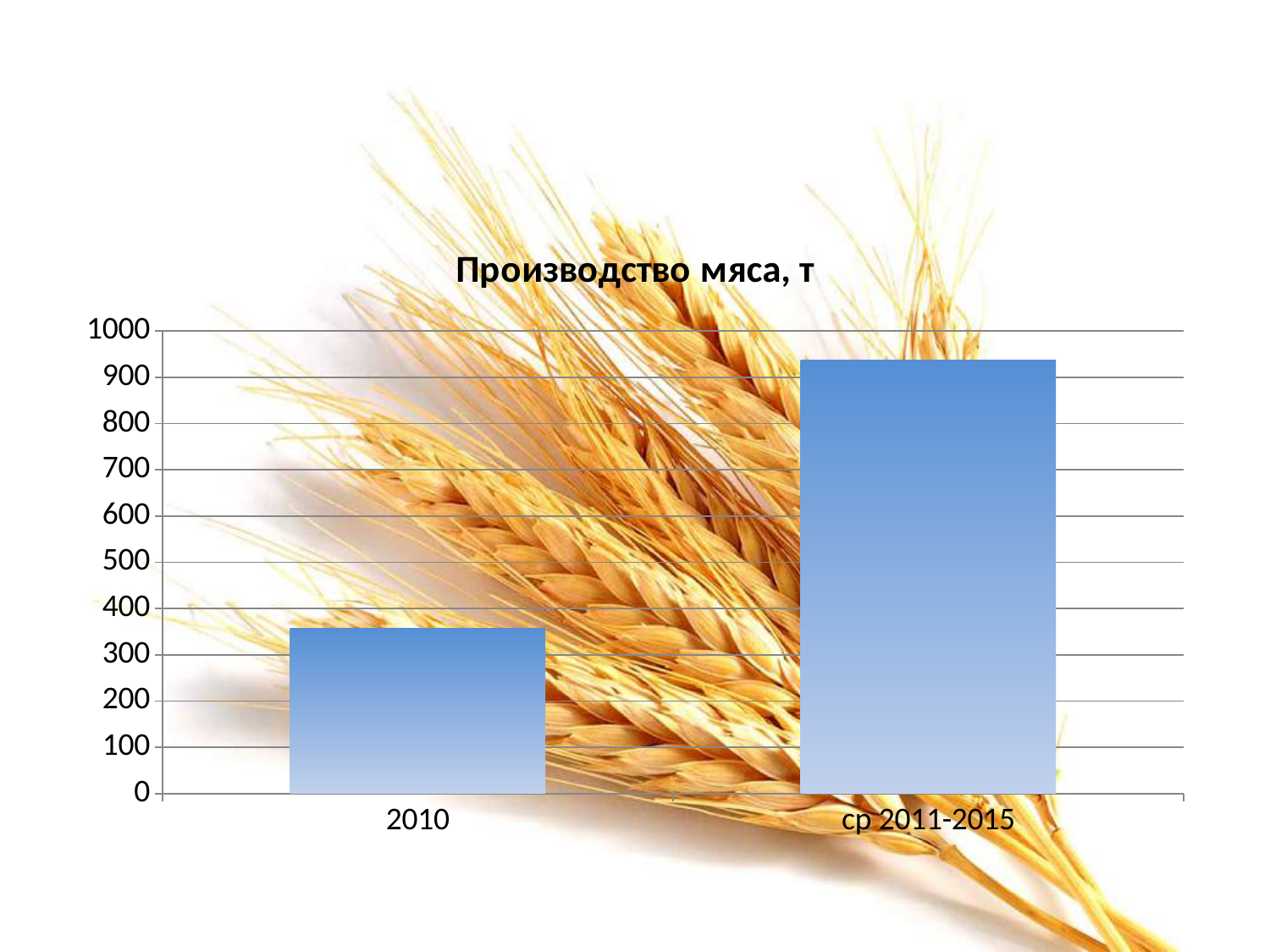
How many bars does the chart show? 2 Which category has the highest value? ср 2011-2015 What kind of chart is shown on the slide? bar chart Is the value for ср 2011-2015 greater or less than 900? greater Is the value for 2010 greater or less than 300? greater Is the value for 2010 greater or less than 400? less Which is larger, the value for 2010 or the value for ср 2011-2015? ср 2011-2015 What is the title of the chart? Производство мяса, т Do the values rise or fall from 2010 to ср 2011-2015? rise What is the maximum value shown on the vertical axis? 1000 Which category has the lowest value? 2010